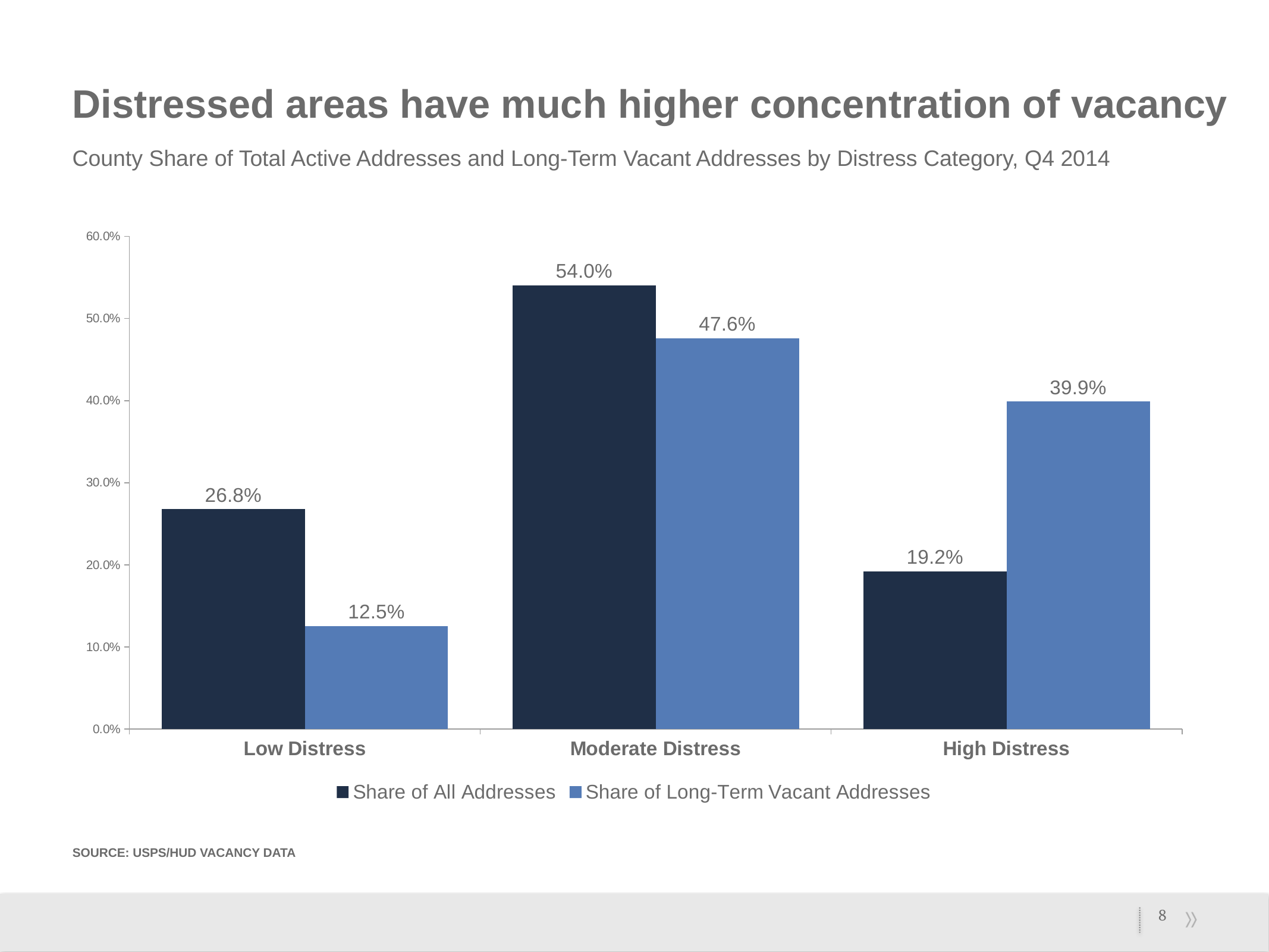
How many series does the legend list? 2 Is the Share of All Addresses for High Distress greater or less than 20.0%? less For Low Distress, which is larger: Share of All Addresses or Share of Long-Term Vacant Addresses? Share of All Addresses What is the source cited for the chart data? USPS/HUD Vacancy Data What kind of chart is shown on the slide? Bar chart Which distress category has the highest Share of All Addresses? Moderate Distress What is the Share of All Addresses for Low Distress? 26.8% What is the difference between the Share of Long-Term Vacant Addresses and the Share of All Addresses for High Distress? 20.7% What is the Share of Long-Term Vacant Addresses for Moderate Distress? 47.6% How many distress categories are shown on the x axis? 3 Which distress category has the lowest Share of Long-Term Vacant Addresses? Low Distress What is the Share of Long-Term Vacant Addresses for High Distress? 39.9%